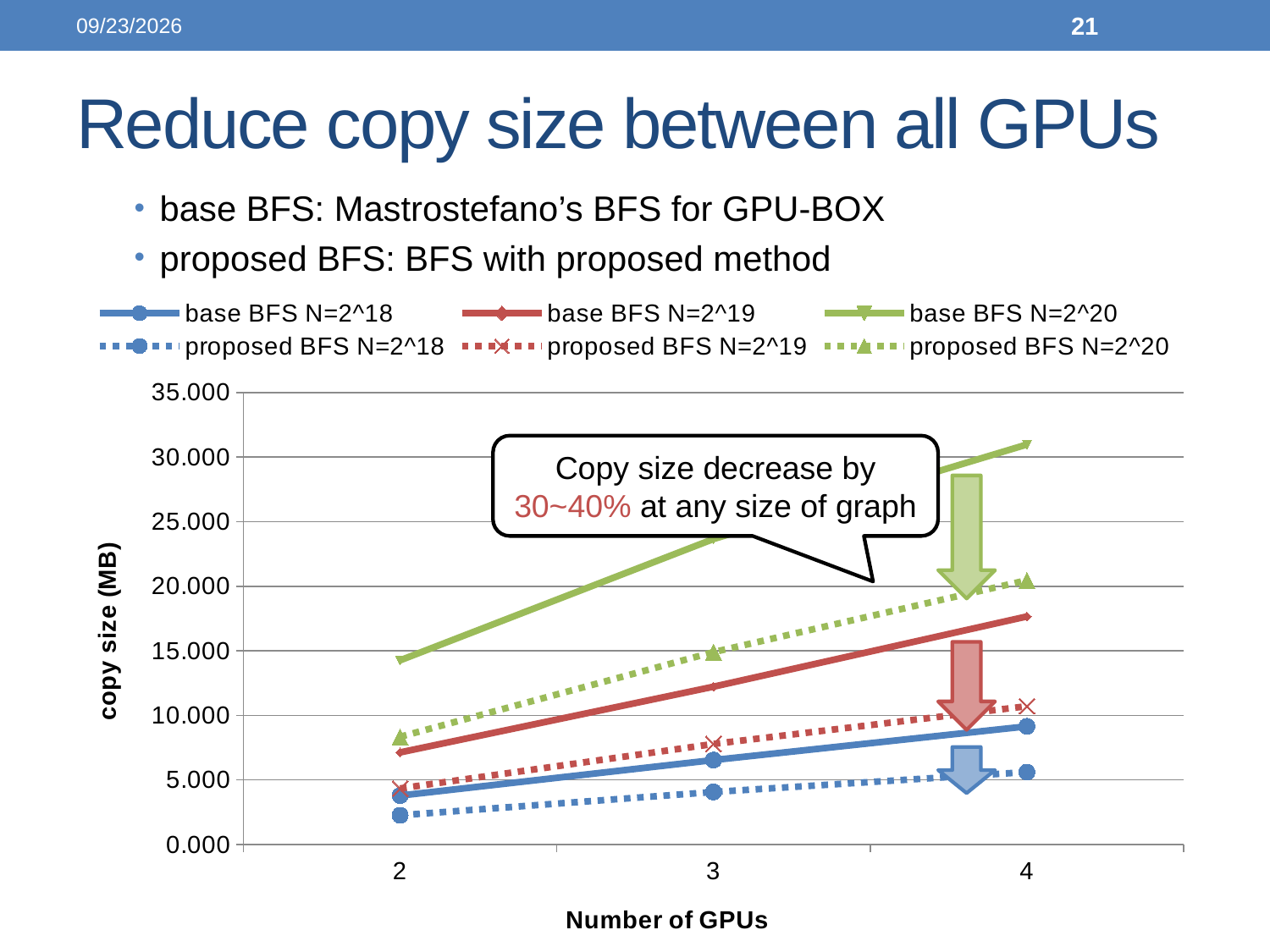
What kind of chart is shown on the slide? line chart How many values of Number of GPUs are plotted on the x axis? 3 Is the copy size for proposed BFS N=2^18 at 4 GPUs greater or less than 10.000? less Which series has the highest copy size at 4 GPUs? base BFS N=2^20 Is the copy size for proposed BFS N=2^20 at 4 GPUs greater or less than 25.000? less Is the copy size for base BFS N=2^19 at 2 GPUs greater or less than 10.000? less What is the label of the y axis? copy size (MB) Does the copy size for base BFS N=2^20 rise or fall as the number of GPUs increases? rise At 4 GPUs, which has the larger copy size: base BFS N=2^19 or proposed BFS N=2^19? base BFS N=2^19 Which series has the lowest copy size at 2 GPUs? proposed BFS N=2^18 How many series does the legend list? 6